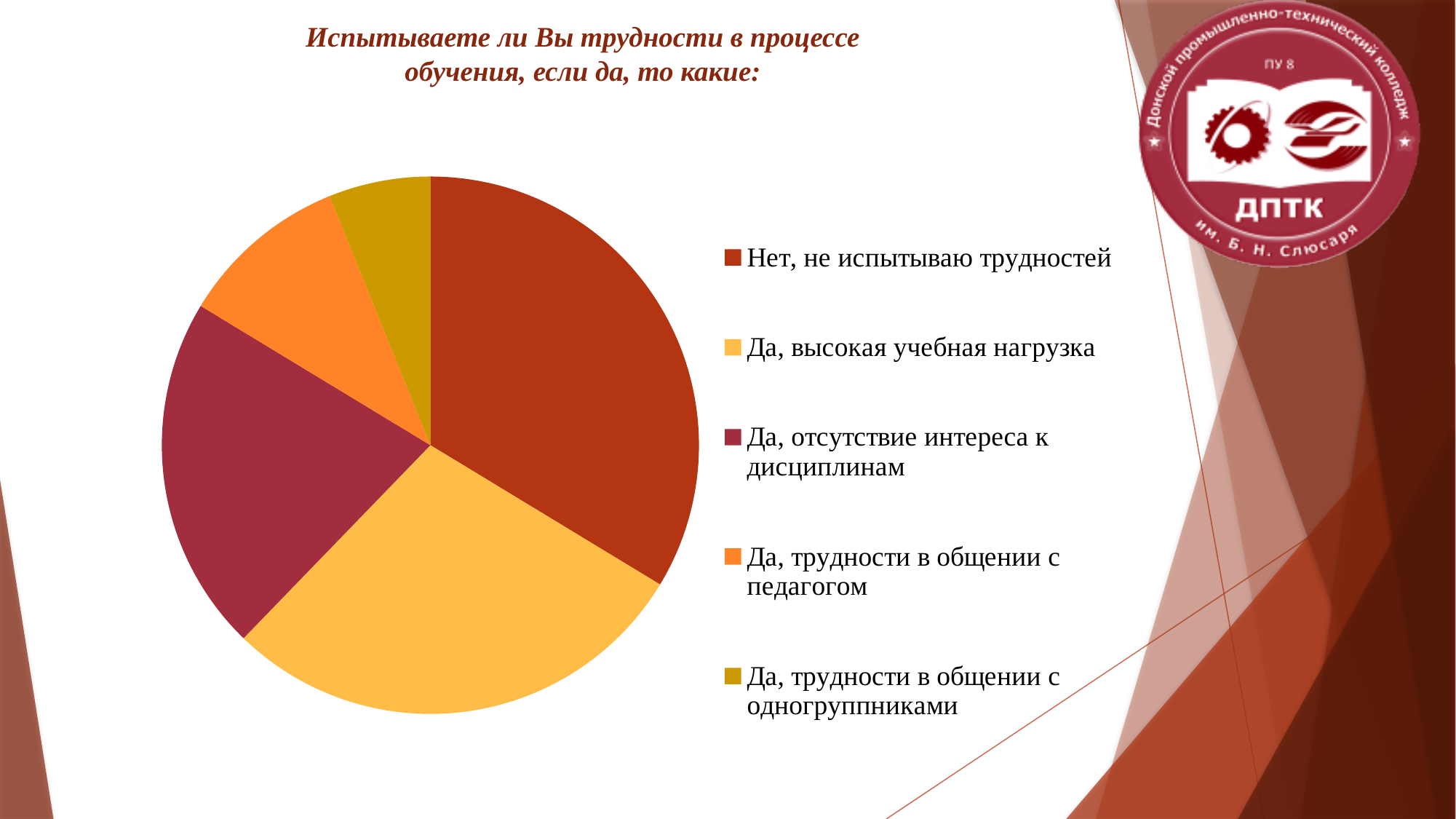
How many categories (slices) does the pie chart have? 5 Which category has the largest slice of the pie chart? Нет, не испытываю трудностей Which slice is larger: "Да, отсутствие интереса к дисциплинам" or "Да, трудности в общении с одногруппниками"? Да, отсутствие интереса к дисциплинам Which slice is larger: "Да, высокая учебная нагрузка" or "Да, отсутствие интереса к дисциплинам"? Да, высокая учебная нагрузка Which slice is larger: "Да, высокая учебная нагрузка" or "Да, трудности в общении с педагогом"? Да, высокая учебная нагрузка What kind of chart is shown on the slide? pie chart Which category has the smallest slice of the pie chart? Да, трудности в общении с одногруппниками Which legend entry is shown in the dark red colour of the largest slice? Нет, не испытываю трудностей What is the title of the chart on the slide? Испытываете ли Вы трудности в процессе обучения, если да, то какие: